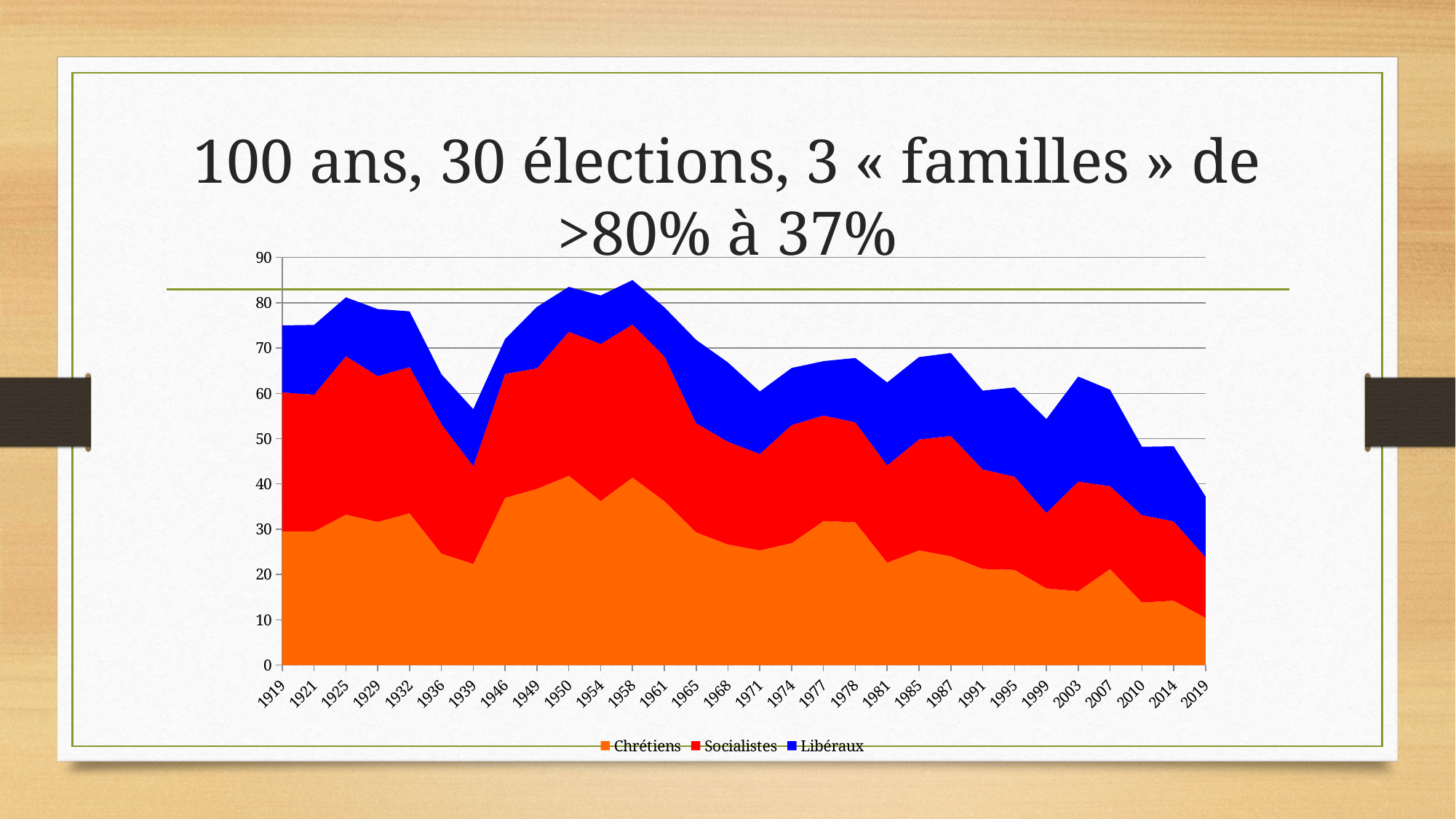
How many series does the legend list? 3 Is the value for Chrétiens in 1946 greater or less than 30? greater What kind of chart is shown on the slide? Stacked area chart Is the combined total of the three families in 1958 greater or less than 80? greater Overall, does the combined total of the three families rise or fall from 1919 to 2019? fall Is the combined total of the three families in 2019 greater or less than 40? less Which series is plotted at the bottom of the stack, in orange? Chrétiens How many election years are shown along the x axis? 30 In which election year is the combined total of the three families lowest? 2019 Is the value for Chrétiens larger in 1950 or in 2019? 1950 Which series is shown in blue in the legend? Libéraux